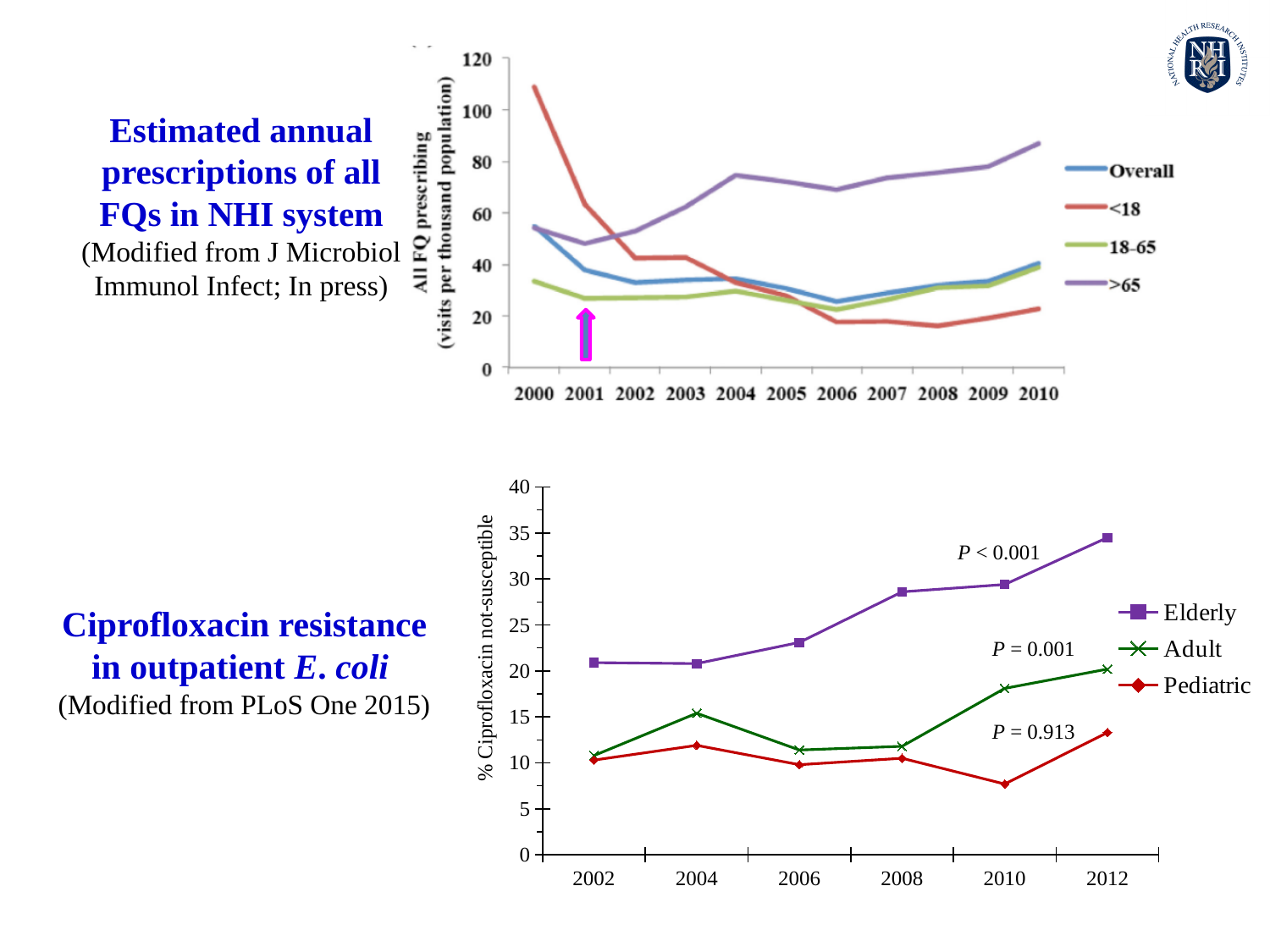
In the bottom chart (Ciprofloxacin resistance), is the value for Elderly in 2012 greater or less than 30? greater In the top chart (FQ prescriptions), does the <18 line rise or fall from 2000 to 2006? fall In the top chart (FQ prescriptions), how many years are shown on the x axis? 11 In the top chart (FQ prescriptions), which age group has the lowest value in 2010? <18 In the bottom chart (Ciprofloxacin resistance), which group has the highest value in 2012? Elderly In the top chart (FQ prescriptions), is the value for <18 in 2000 greater or less than 100? greater In the bottom chart (Ciprofloxacin resistance), is the value for Pediatric in 2010 greater or less than 10? less In the top chart (FQ prescriptions), how many series does the legend list? 4 In the bottom chart (Ciprofloxacin resistance), what P value is shown next to the Pediatric line? P = 0.913 What kind of chart is the top chart, 'Estimated annual prescriptions of all FQs in NHI system'? line chart In the bottom chart (Ciprofloxacin resistance in outpatient E. coli), how many series does the legend list? 3 In the top chart (FQ prescriptions), which age group has the highest value in 2000? <18